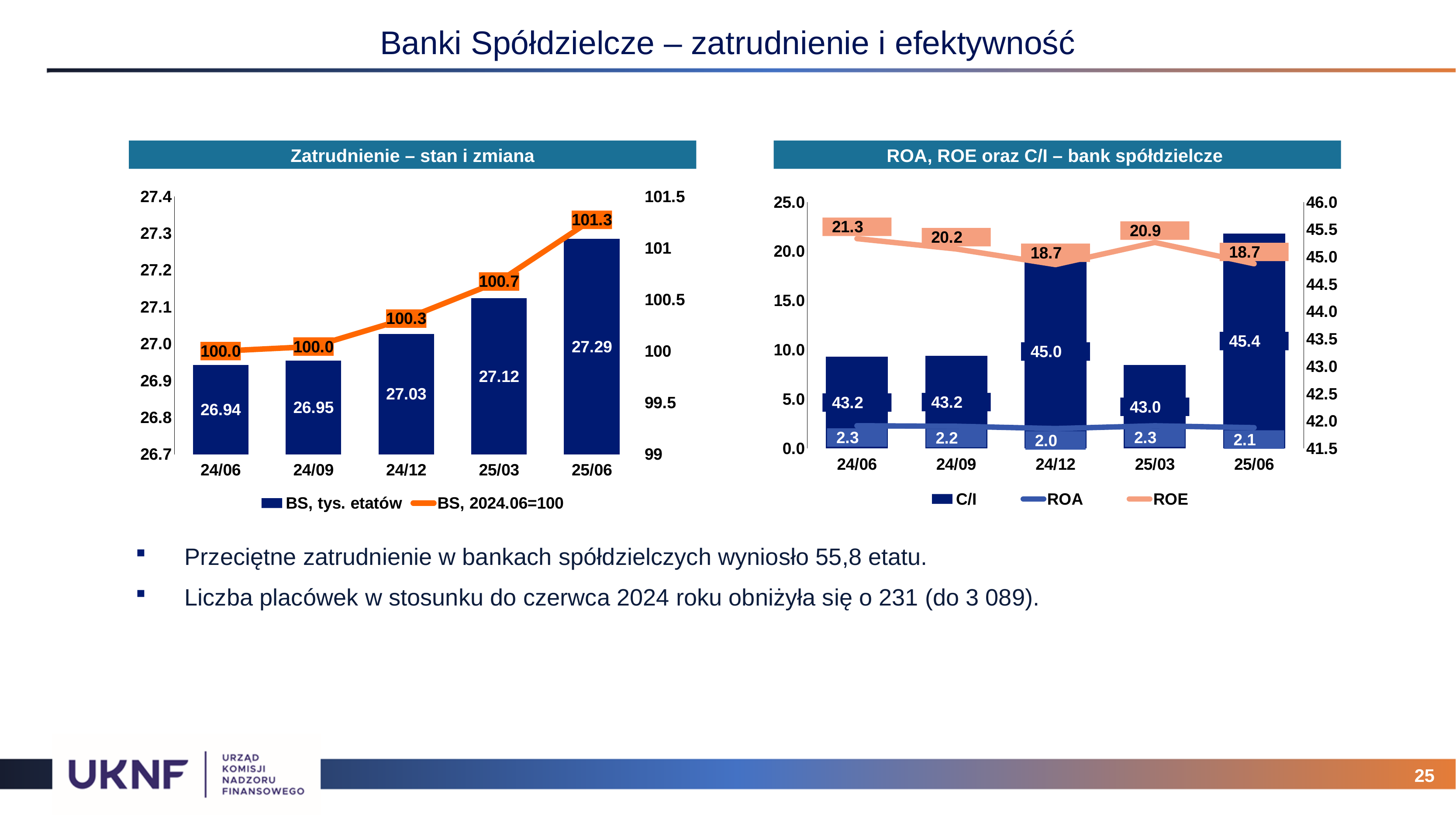
In the chart titled "ROA, ROE oraz C/I – bank spółdzielcze", which period has the highest C/I value? 25/06 In the chart titled "ROA, ROE oraz C/I – bank spółdzielcze", how many periods are shown on the x axis? 5 In the chart titled "Zatrudnienie – stan i zmiana", do the BS, tys. etatów values rise or fall from 24/06 to 25/06? rise In the chart titled "Zatrudnienie – stan i zmiana", what is the difference in BS, tys. etatów between 25/06 and 24/06? 0.35 In the chart titled "ROA, ROE oraz C/I – bank spółdzielcze", what is the C/I value for 24/12? 45.0 In the chart titled "ROA, ROE oraz C/I – bank spółdzielcze", what is the ROE value for 24/06? 21.3 In the chart titled "Zatrudnienie – stan i zmiana", what is the value of BS, 2024.06=100 for 25/03? 100.7 In the chart titled "Zatrudnienie – stan i zmiana", how many series does the legend list? 2 In the chart titled "Zatrudnienie – stan i zmiana", which period has the lowest value of BS, tys. etatów? 24/06 In the chart titled "ROA, ROE oraz C/I – bank spółdzielcze", which period has the lowest ROA value? 24/12 In the chart titled "Zatrudnienie – stan i zmiana", what is the value of BS, tys. etatów for 25/06? 27.29 In the chart titled "ROA, ROE oraz C/I – bank spółdzielcze", is the ROE value for 25/03 larger or smaller than the ROE value for 24/09? larger